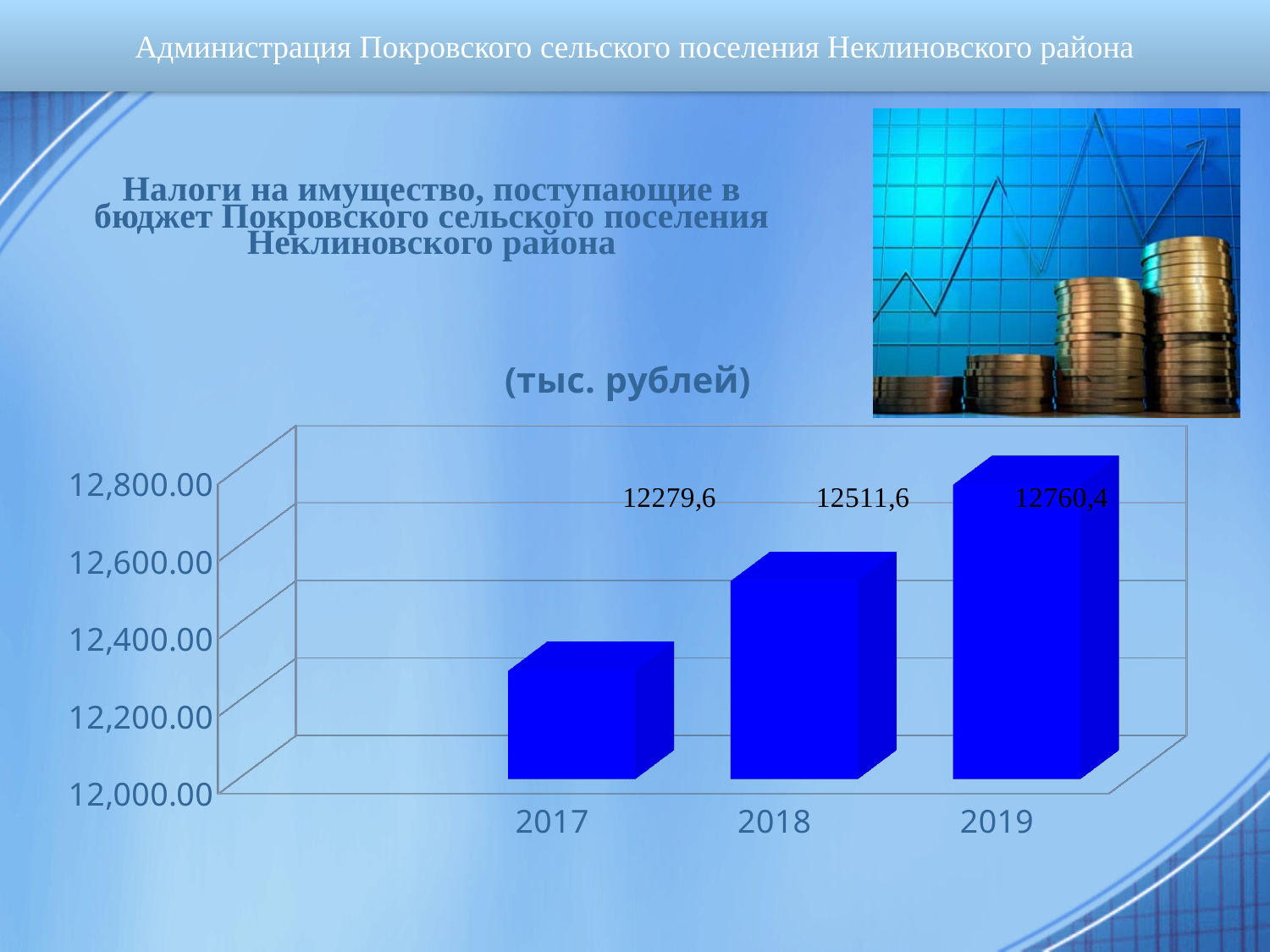
Which year has the highest value in the chart? 2019 Do the values rise or fall from 2017 to 2019? rise What is the difference between the values for 2018 and 2017? 232,0 What is the value for 2017 in the chart? 12279,6 How many years are shown on the x axis of the chart? 3 What is the value for 2019 in the chart? 12760,4 Is the value for 2017 greater or less than 12,200.00? greater What type of chart is shown on the slide? bar chart What is the difference between the values for 2019 and 2017? 480,8 Which year has the lowest value in the chart? 2017 What is the value for 2018 in the chart? 12511,6 Which is larger, the value for 2018 or the value for 2019? 2019